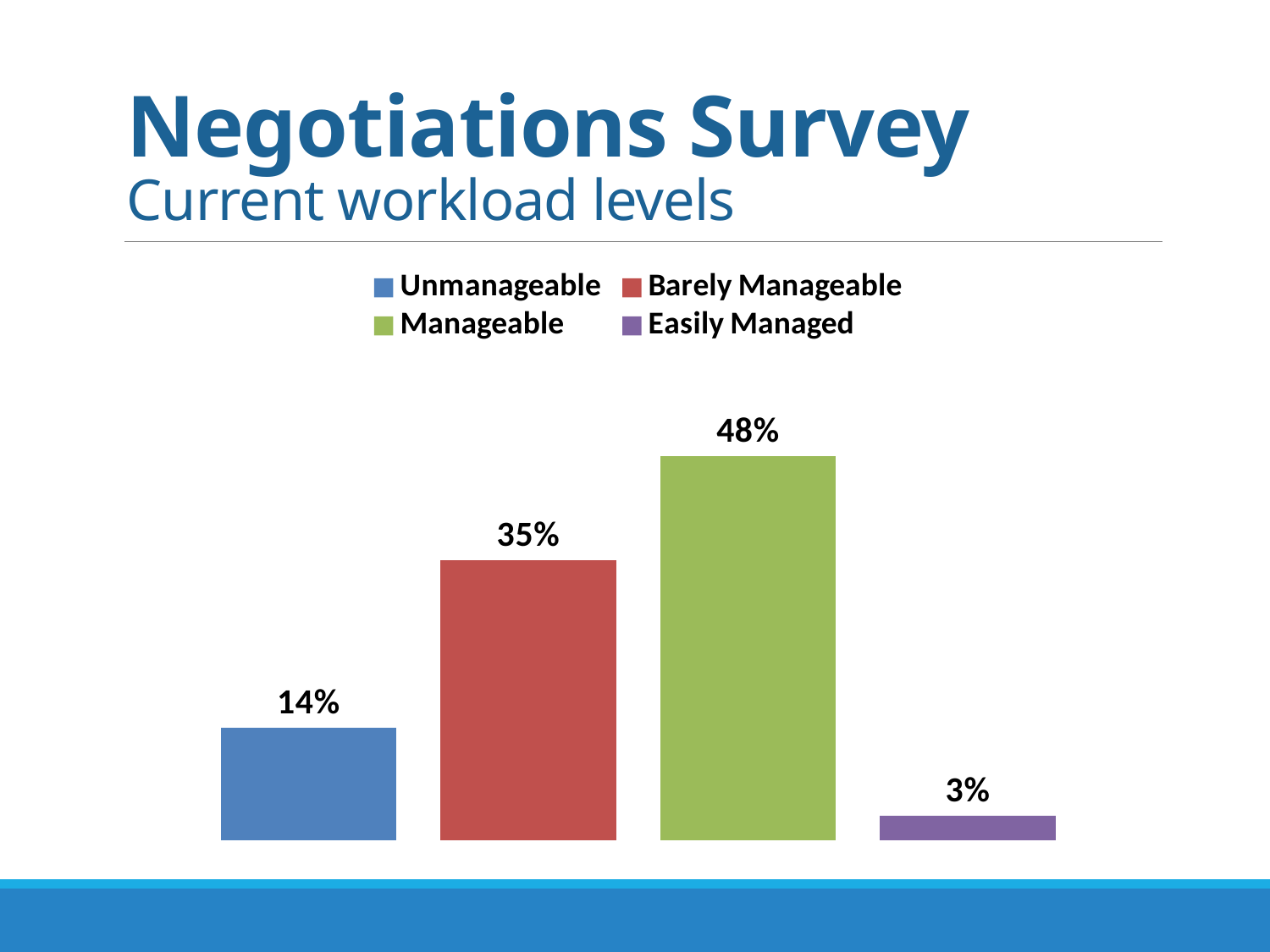
What percentage of respondents rated their workload as Barely Manageable? 35% What percentage of respondents rated their workload as Unmanageable? 14% How many workload categories are shown in the chart? 4 What type of chart is shown on the slide? Bar chart What colour is the bar for Manageable? Green Which workload level has the lowest percentage? Easily Managed What is the difference in percentage points between Manageable and Barely Manageable? 13 Which workload level has the highest percentage? Manageable What is the difference in percentage points between Unmanageable and Easily Managed? 11 What percentage of respondents rated their workload as Easily Managed? 3% Which is larger, the percentage for Unmanageable or for Barely Manageable? Barely Manageable What percentage of respondents rated their workload as Manageable? 48%